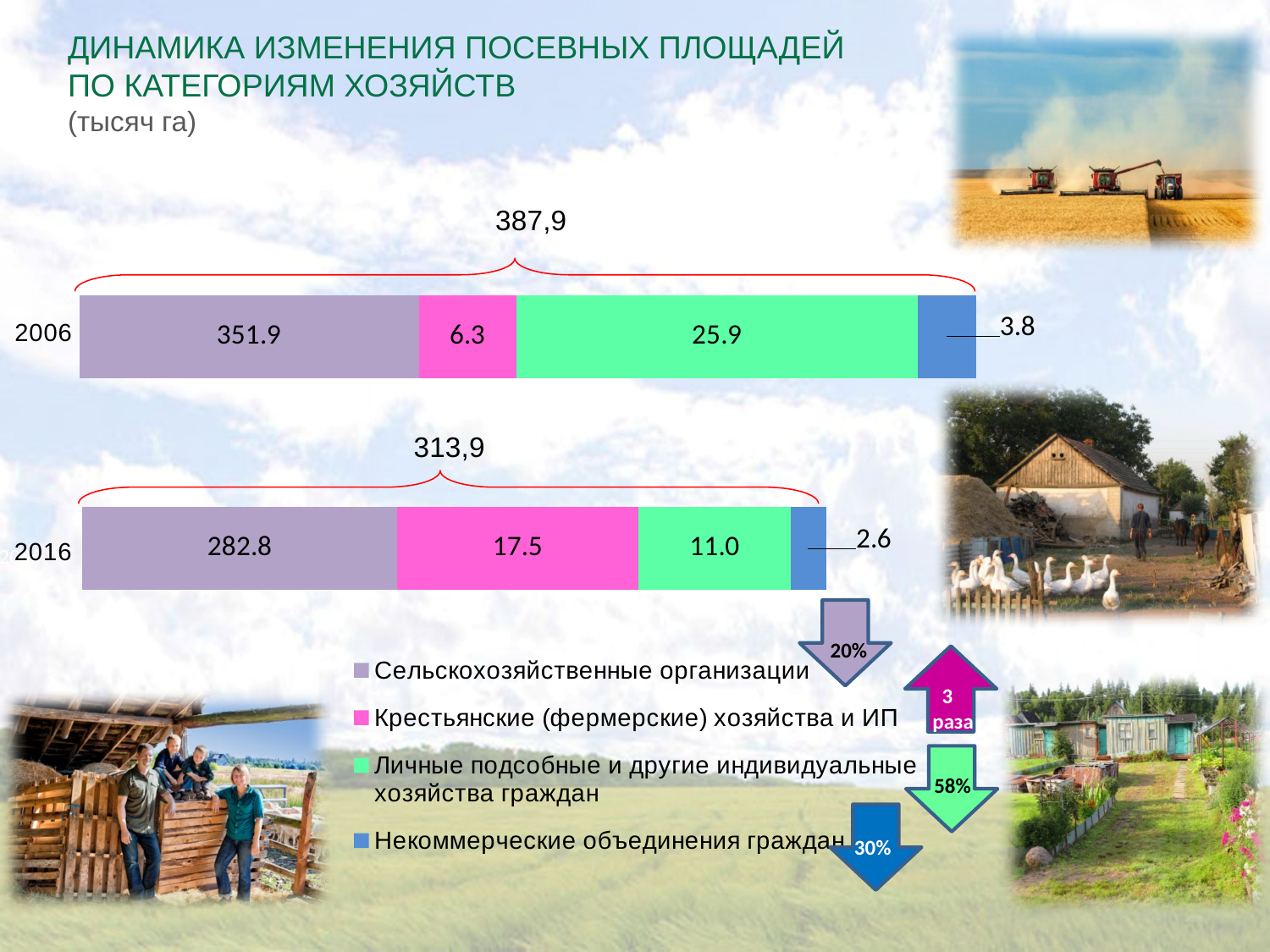
What is the difference between the Сельскохозяйственные организации values for 2006 and 2016? 69.1 Which category has the smallest value in 2006? Некоммерческие объединения граждан What is the total of the stacked bar for 2016? 313,9 What is the value for Личные подсобные и другие индивидуальные хозяйства граждан in 2016? 11.0 What is the value for Сельскохозяйственные организации in 2006? 351.9 What is the total of the stacked bar for 2006? 387,9 How many series does the legend list? 4 What is the value for Крестьянские (фермерские) хозяйства и ИП in 2016? 17.5 Is the value for Крестьянские (фермерские) хозяйства и ИП larger in 2006 or in 2016? 2016 What kind of chart is shown on the slide? Stacked bar chart What is the value for Некоммерческие объединения граждан in 2006? 3.8 Which category has the largest value in 2016? Сельскохозяйственные организации